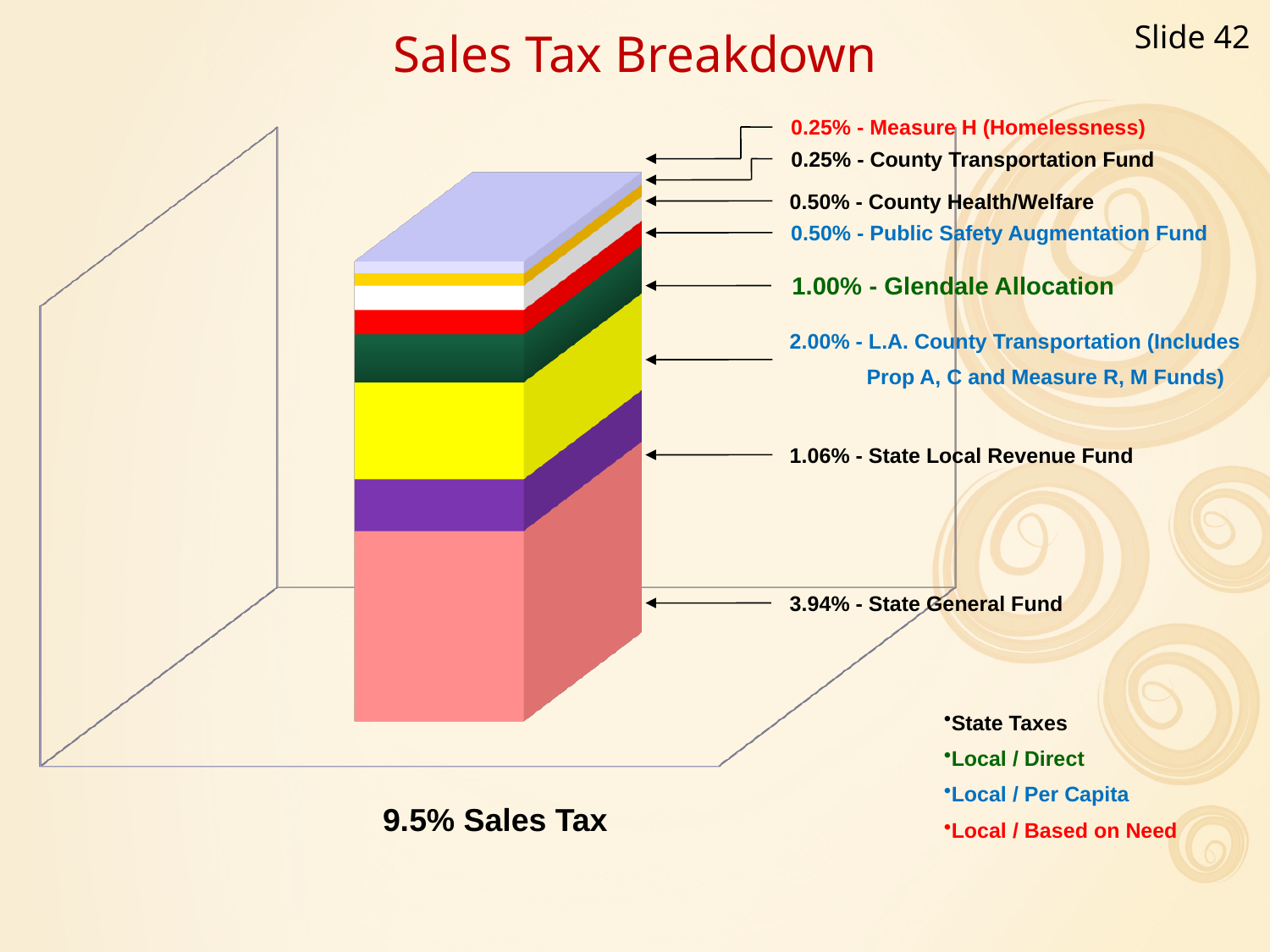
What is the title of the chart? Sales Tax Breakdown What is the value for the State General Fund segment? 3.94% Which segment of the bar is the largest? State General Fund Which is larger, the State Local Revenue Fund segment or the Glendale Allocation segment? State Local Revenue Fund What is the difference between the County Health/Welfare and the Measure H (Homelessness) segments? 0.25% What kind of chart is shown on the slide? stacked bar chart What is the difference between the State General Fund and the L.A. County Transportation segments? 1.94% What is the value for the Glendale Allocation segment? 1.00% What is the value for the State Local Revenue Fund segment? 1.06% What is the value for the L.A. County Transportation segment? 2.00% How many segments make up the stacked bar? 8 What is the total of the stacked bar? 9.5%